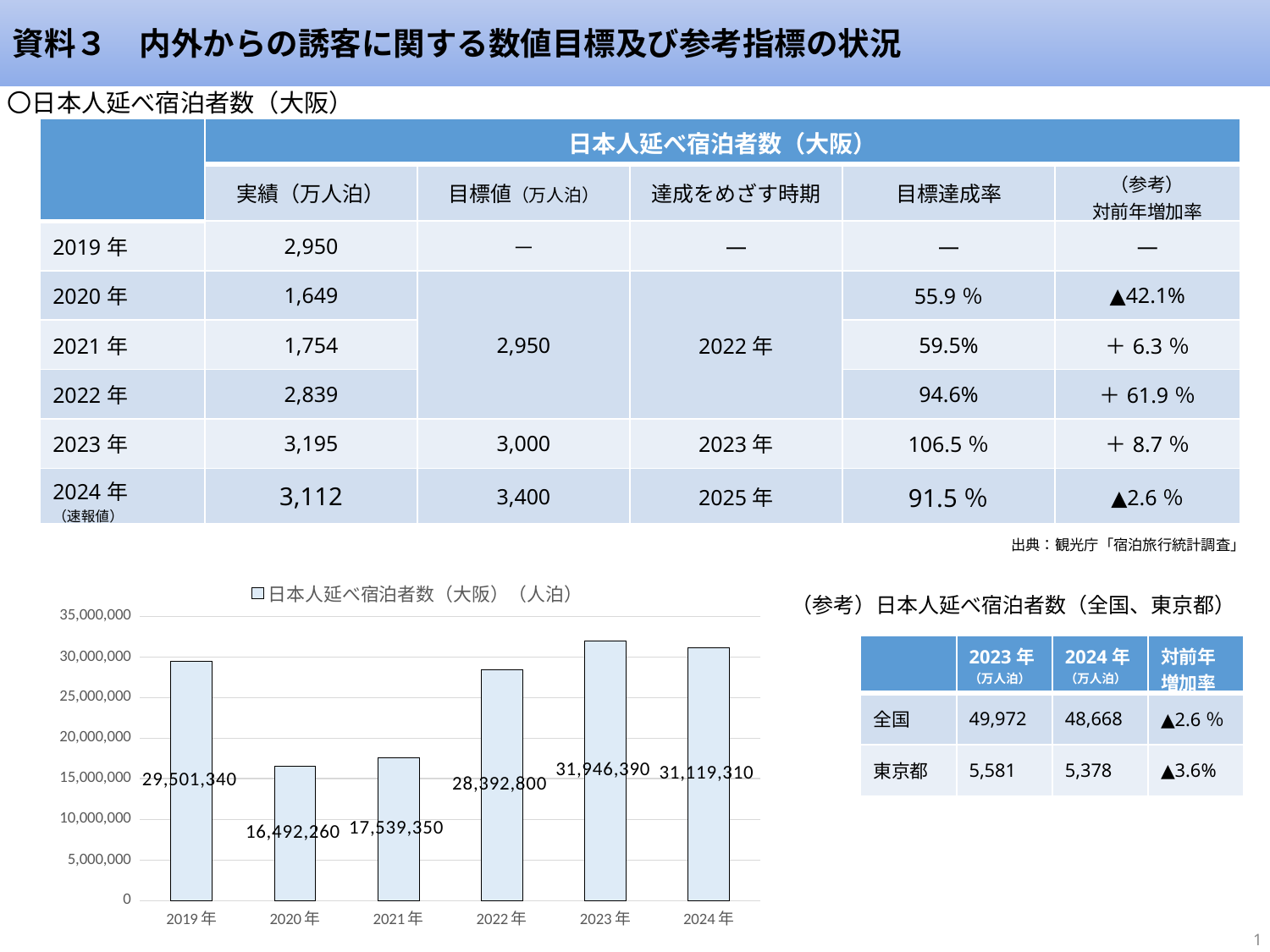
What is the value for 2020年 in the chart? 16,492,260 What is the legend entry of the chart? 日本人延べ宿泊者数（大阪）（人泊） Which year has the lowest value in the chart? 2020年 What is the value for 2022年 in the chart? 28,392,800 What is the value for 2024年 in the chart? 31,119,310 Which is larger in the chart, the value for 2019年 or the value for 2022年? 2019年 Which year has the highest value in the chart? 2023年 What type of chart is shown on the slide? bar chart What is the difference between the values for 2023年 and 2024年 in the chart? 827,080 What is the difference between the values for 2021年 and 2020年 in the chart? 1,047,090 How many years are plotted in the chart? 6 What is the value for 2019年 in the chart? 29,501,340